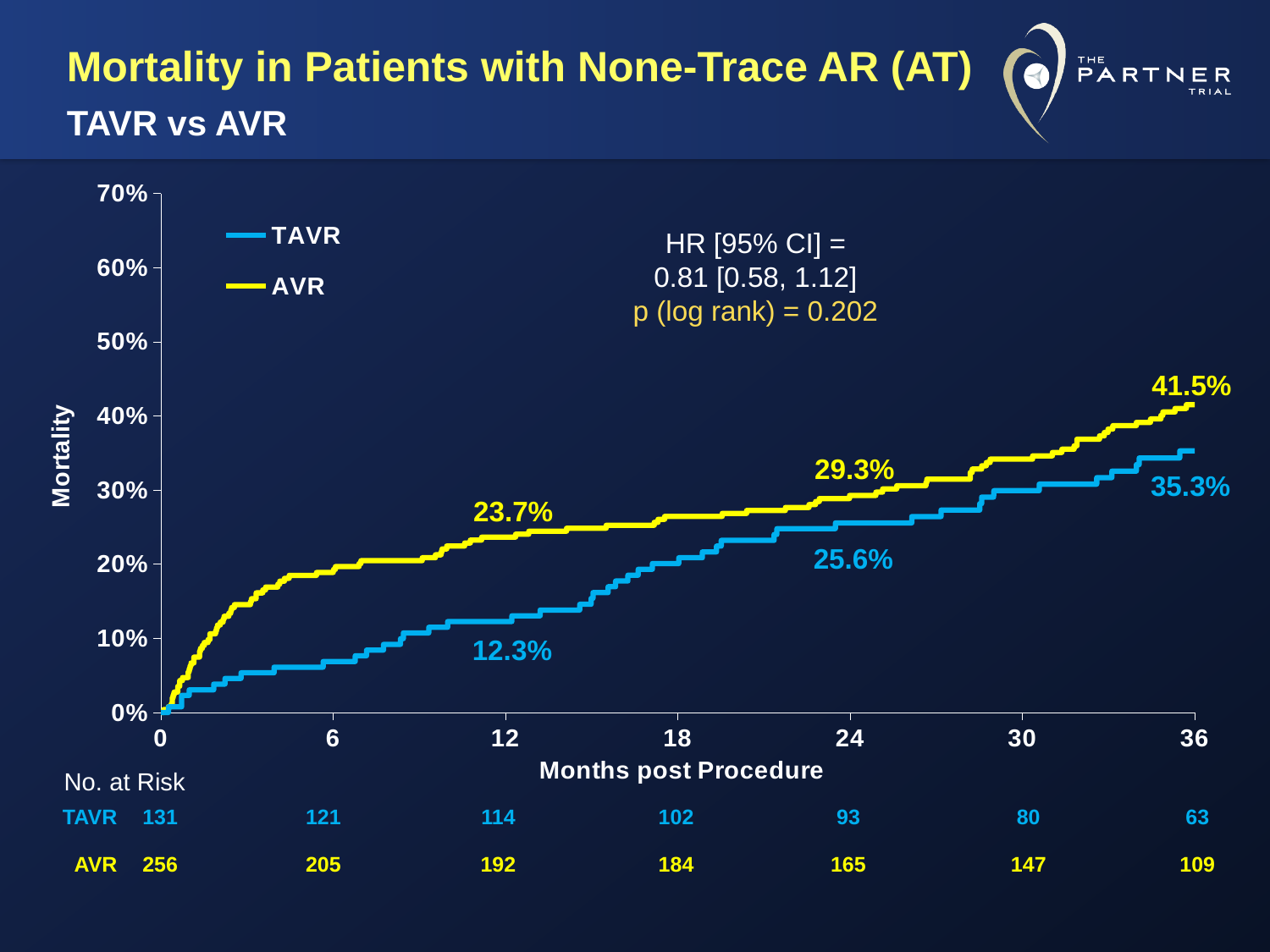
Which group has the higher mortality at 24 months, TAVR or AVR? AVR What is the difference between the AVR and TAVR mortality at 12 months? 11.4% Is the TAVR mortality at 36 months greater or less than 40%? less What is the mortality for AVR at 36 months post procedure? 41.5% What is the mortality for TAVR at 24 months post procedure? 25.6% What kind of chart is shown on the slide? line chart What is the p (log rank) value shown on the chart? 0.202 What is the mortality for TAVR at 12 months post procedure? 12.3% How many series does the legend list? 2 What is the difference between the AVR and TAVR mortality at 36 months? 6.2% What is the mortality for AVR at 12 months post procedure? 23.7% Does the mortality for TAVR rise or fall as months post procedure increase? rise